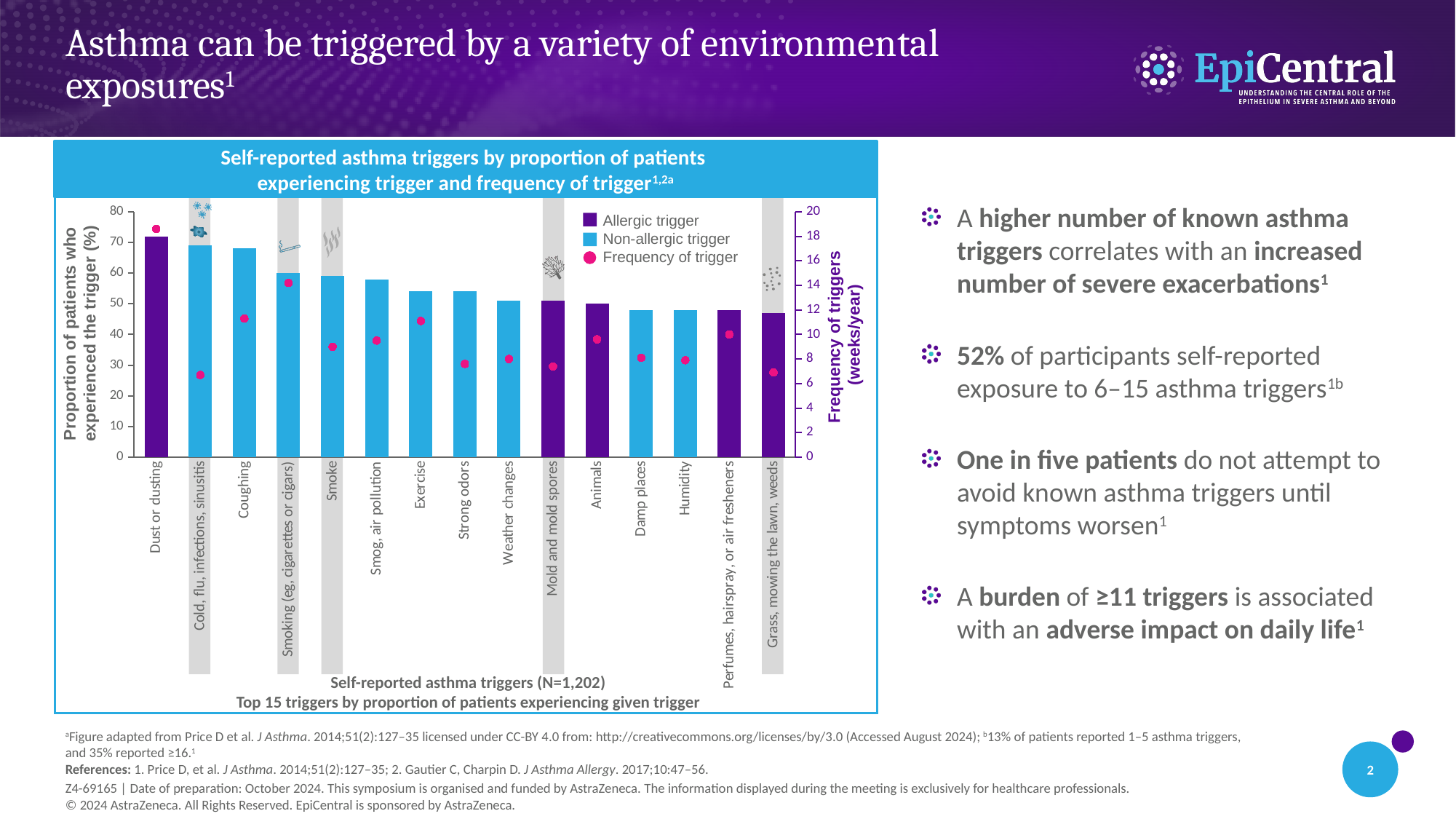
What kind of chart is used to show the proportion of patients experiencing each trigger? bar chart Which colour is used for the allergic trigger bars in the chart? purple Which trigger has the highest frequency of trigger (weeks/year)? Dust or dusting How many entries does the chart legend list? 3 Is the frequency of trigger for Cold, flu, infections, sinusitis greater or less than 8 weeks/year? less Is the proportion of patients for Exercise greater or less than 50%? greater Is the proportion of patients for Coughing greater or less than 60%? greater Do the bars for proportion of patients rise or fall from left to right along the x axis? fall How many asthma triggers are shown along the x axis of the chart? 15 Which trigger has the highest proportion of patients who experienced it? Dust or dusting